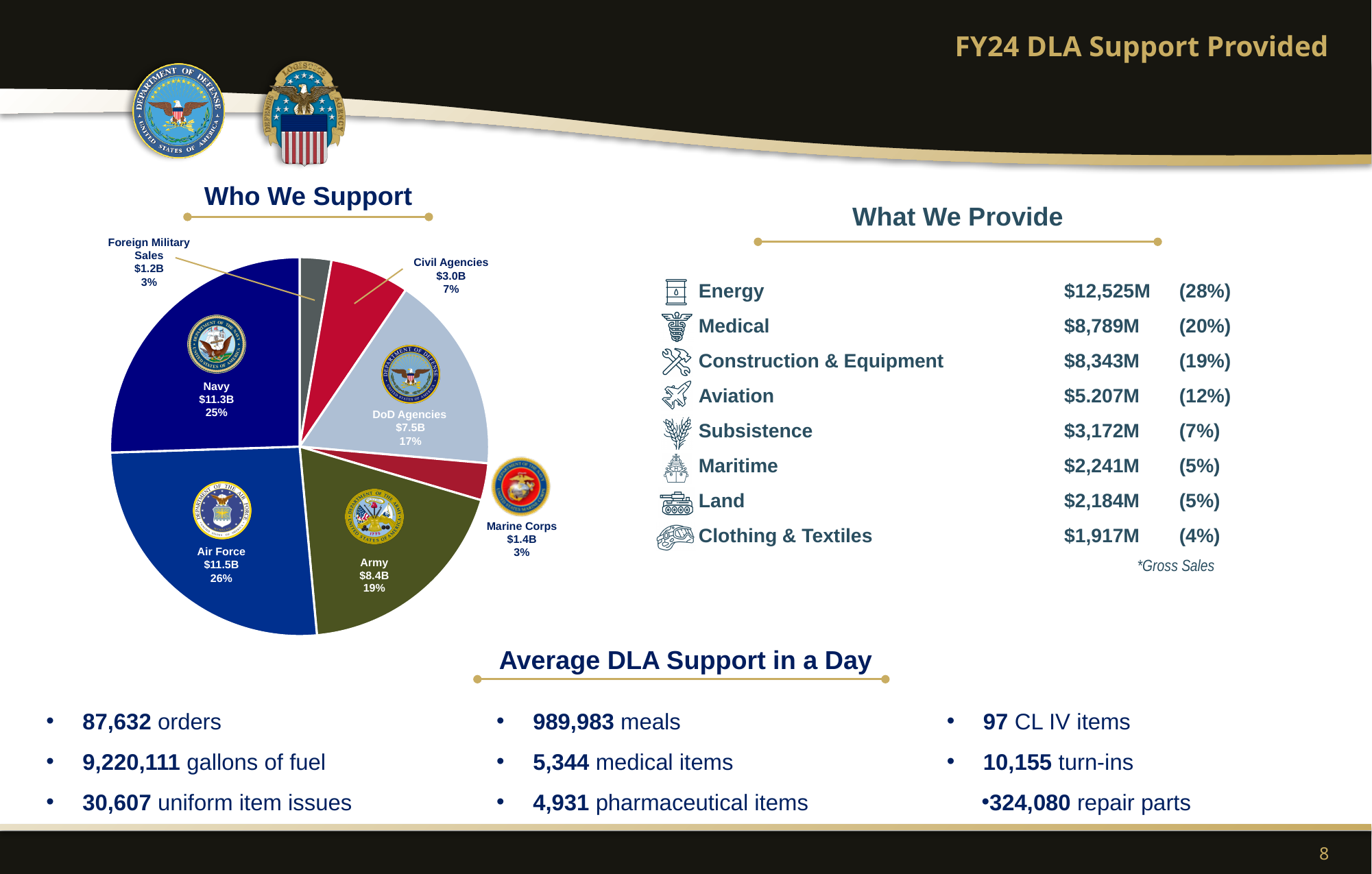
In the "Who We Support" pie chart, what is the difference between the Air Force value and the Navy value? $0.2B In the "Who We Support" pie chart, what is the value for DoD Agencies? $7.5B In the "Who We Support" pie chart, what share of the pie do Civil Agencies represent? 7% How many categories are shown in the "Who We Support" pie chart? 7 In the "Who We Support" pie chart, what share of the pie does the Air Force represent? 26% In the "Who We Support" pie chart, what is the value for the Army? $8.4B What type of chart is shown under "Who We Support"? pie chart In the "Who We Support" pie chart, which is larger, the Army value or the DoD Agencies value? Army In the "Who We Support" pie chart, what is the value for the Navy? $11.3B In the "Who We Support" pie chart, which category has the largest value? Air Force In the "Who We Support" pie chart, which category has the smallest value? Foreign Military Sales In the "Who We Support" pie chart, what is the value for the Marine Corps? $1.4B